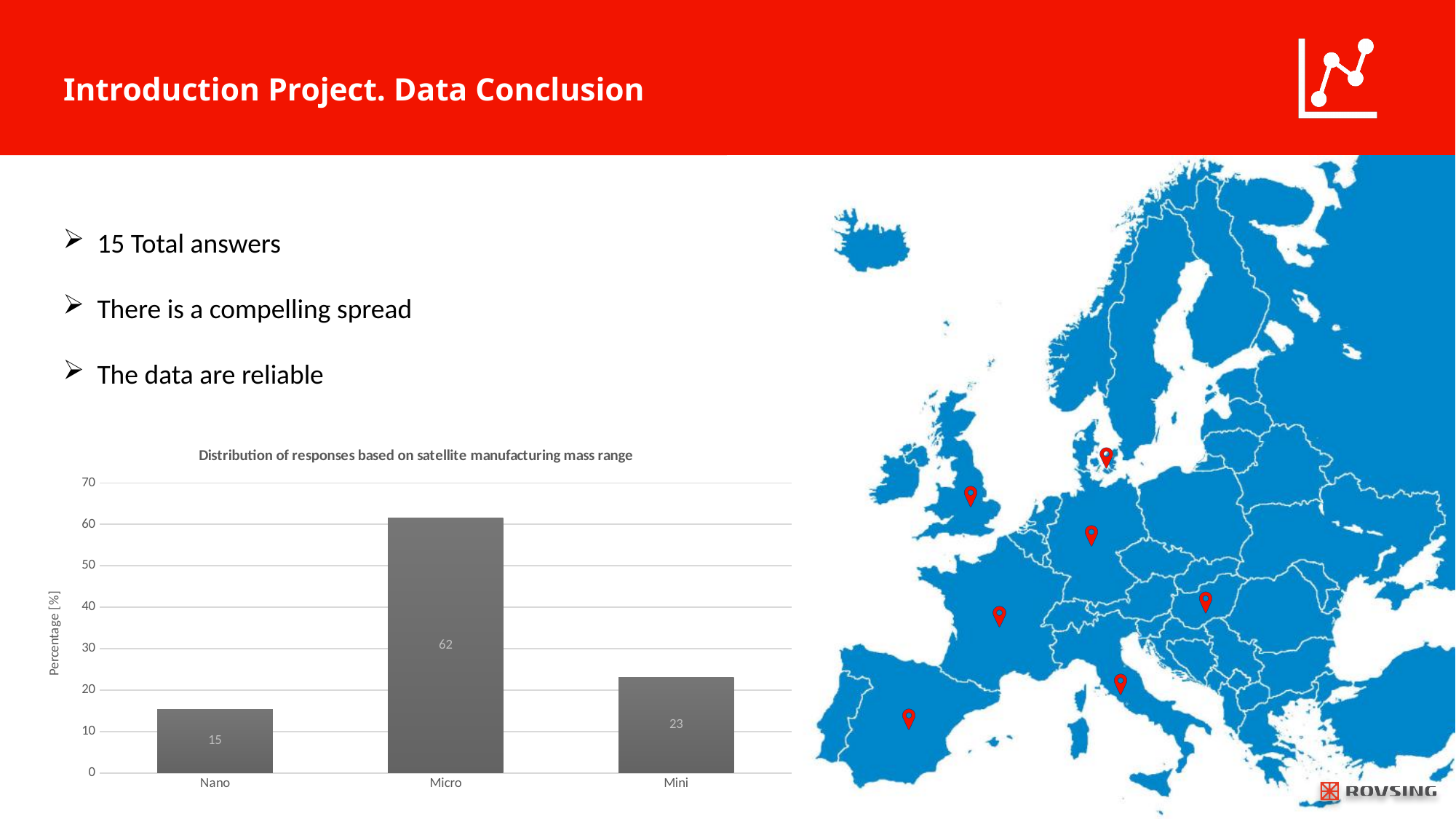
Which category has the lowest value? Nano What is the value for Mini in the chart? 23 What kind of chart is shown on the slide? bar chart What is the title of the chart? Distribution of responses based on satellite manufacturing mass range What is the difference between the values for Micro and Mini? 39 How many categories are shown on the x axis of the chart? 3 Which category has the highest value? Micro Which is larger, the value for Mini or the value for Nano? Mini What is the value for Nano in the chart? 15 What is the value for Micro in the chart? 62 Is the value for Micro greater or less than 50? greater What is the difference between the values for Mini and Nano? 8